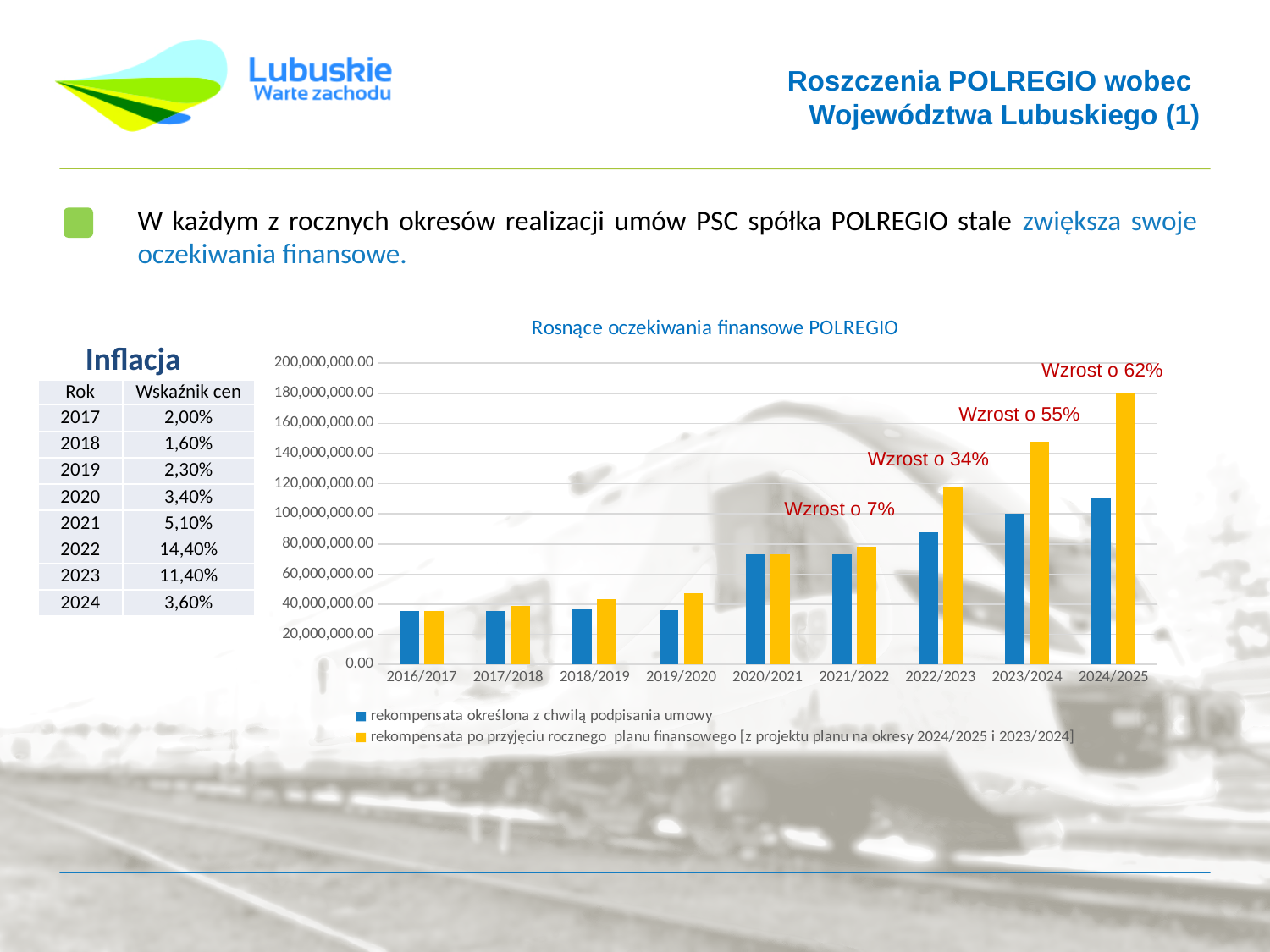
Is the value for 'rekompensata określona z chwilą podpisania umowy' in 2024/2025 greater or less than 100,000,000.00? greater What percentage increase ('Wzrost') is annotated above the 2024/2025 bars? Wzrost o 62% What is the title of the chart? Rosnące oczekiwania finansowe POLREGIO Is the value for 'rekompensata po przyjęciu rocznego planu finansowego' in 2023/2024 greater or less than 140,000,000.00? greater Is the value for 'rekompensata po przyjęciu rocznego planu finansowego' in 2024/2025 greater or less than 160,000,000.00? greater How many series does the chart's legend list? 2 How many annual periods (categories) are shown on the x axis of the chart? 9 Do the values for 'rekompensata określona z chwilą podpisania umowy' generally rise or fall from 2016/2017 to 2024/2025? rise What kind of chart is shown under the title 'Rosnące oczekiwania finansowe POLREGIO'? bar chart In 2024/2025, which is larger: 'rekompensata określona z chwilą podpisania umowy' or 'rekompensata po przyjęciu rocznego planu finansowego'? rekompensata po przyjęciu rocznego planu finansowego Which period has the highest value for 'rekompensata po przyjęciu rocznego planu finansowego'? 2024/2025